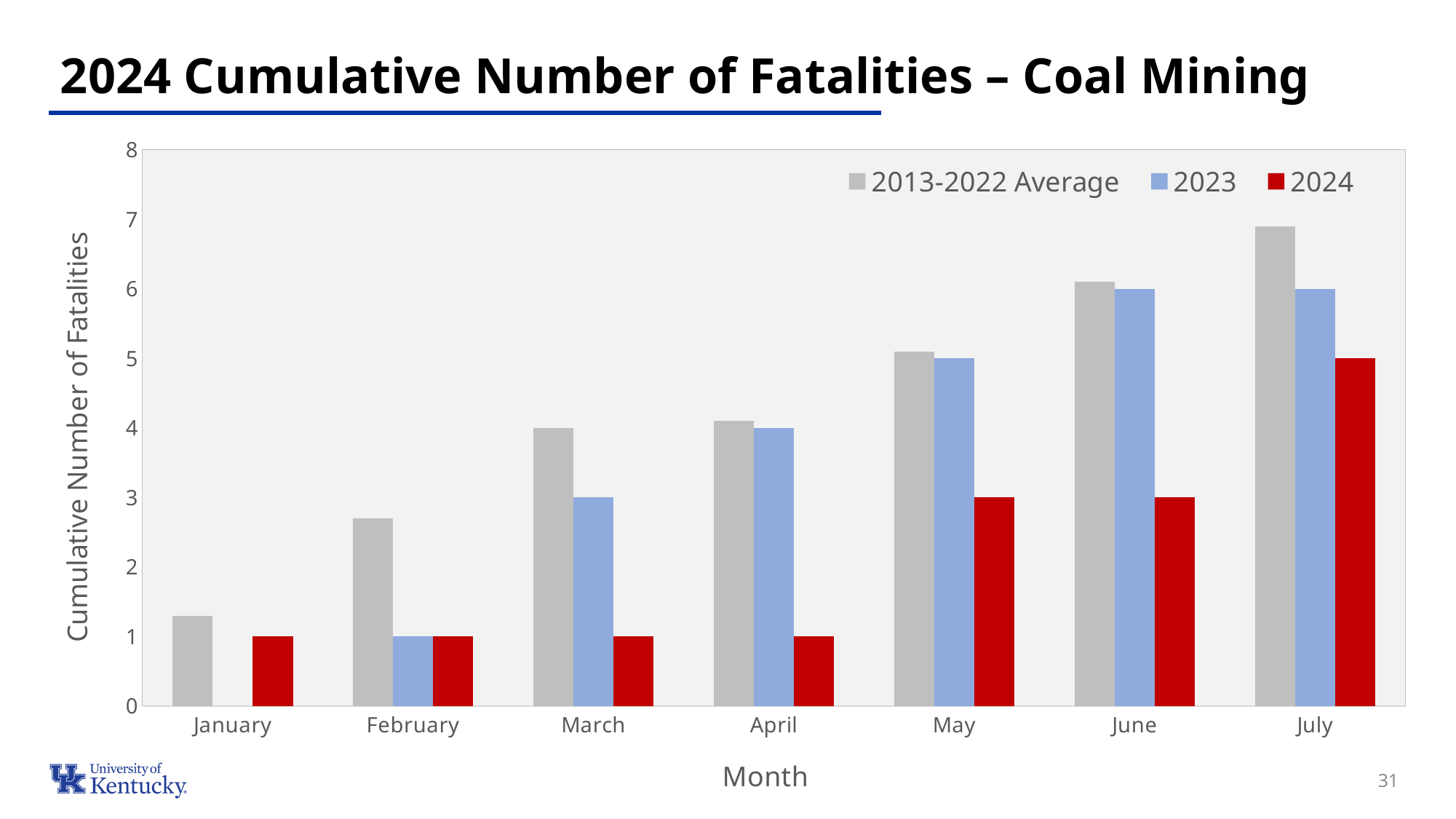
What is the difference between the 2023 and 2024 values for July? 1 What is the 2024 cumulative number of fatalities for July? 5 What is the 2023 cumulative number of fatalities for April? 4 Which is larger in March, the 2023 value or the 2024 value? 2023 How many months are shown on the x axis? 7 How many series does the legend list? 3 What kind of chart is shown on the slide? bar chart What is the 2024 cumulative number of fatalities for May? 3 Do the 2024 values rise or fall from January to July? rise What is the 2023 cumulative number of fatalities for June? 6 In which month is the 2024 value highest? July Is the 2013-2022 Average value for July greater or less than 6? greater